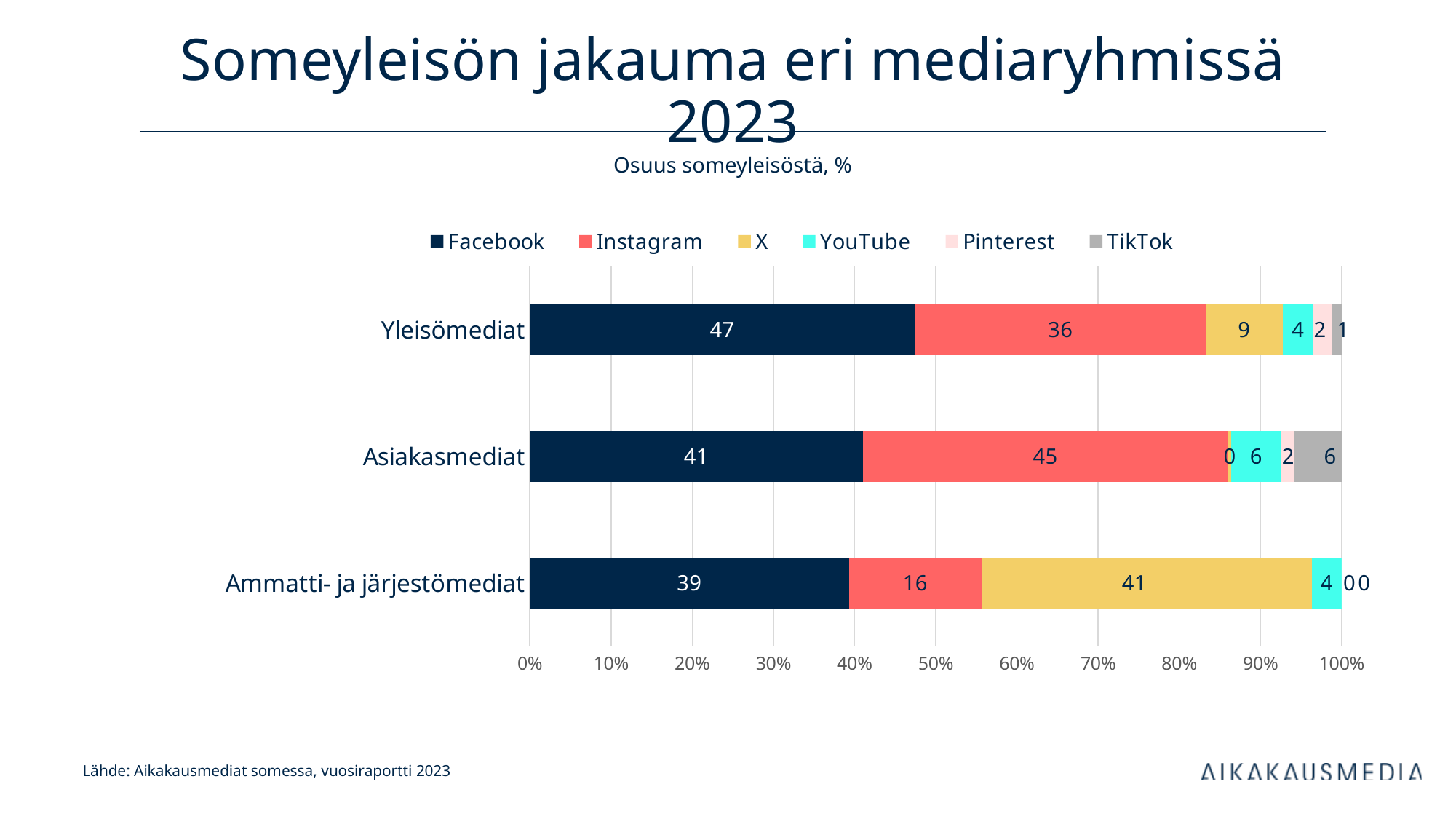
What is the TikTok share for Asiakasmediat? 6 Which media group has the lowest Instagram share? Ammatti- ja järjestömediat How many media groups are shown on the chart? 3 What is the X share for Ammatti- ja järjestömediat? 41 What is the Facebook share for Yleisömediat? 47 What is the Instagram share for Asiakasmediat? 45 For Yleisömediat, what is the difference between the Facebook share and the Instagram share? 11 How many series does the legend list? 6 What is the subtitle shown above the chart? Osuus someyleisöstä, % For Asiakasmediat, which is larger: the Facebook share or the Instagram share? Instagram Which media group has the highest Facebook share? Yleisömediat What kind of chart is shown on the slide? Stacked bar chart